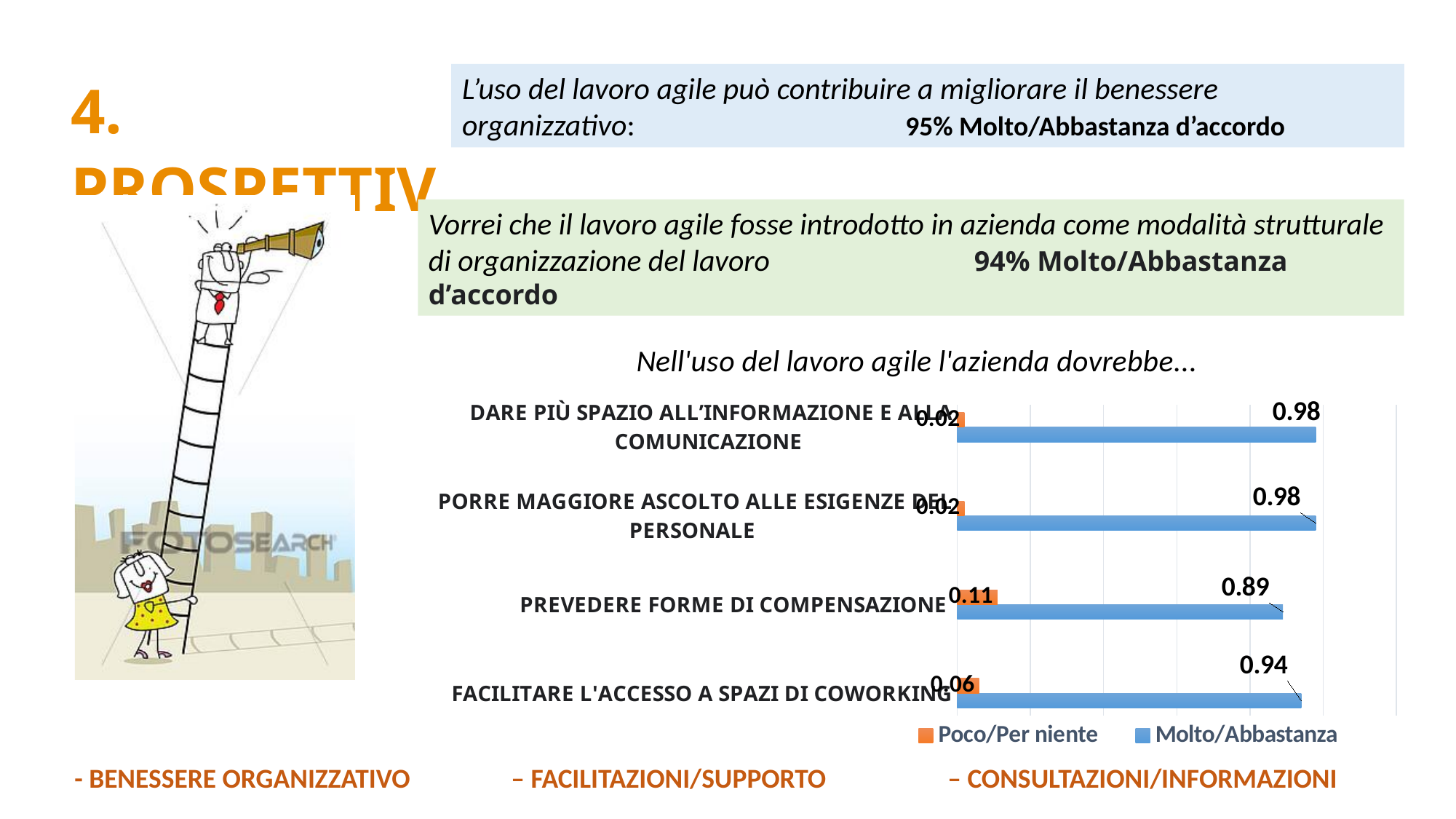
What is the Poco/Per niente value for 'Facilitare l'accesso a spazi di coworking'? 0.06 What is the difference between the Molto/Abbastanza values for 'Facilitare l'accesso a spazi di coworking' and 'Prevedere forme di compensazione'? 0.05 Which category has the highest Poco/Per niente value? Prevedere forme di compensazione What type of chart is shown on the slide? Bar chart What is the Molto/Abbastanza value for 'Prevedere forme di compensazione'? 0.89 What is the Molto/Abbastanza value for 'Porre maggiore ascolto alle esigenze del personale'? 0.98 What is the Poco/Per niente value for 'Prevedere forme di compensazione'? 0.11 How many series does the chart legend list? 2 What is the title of the chart? Nell'uso del lavoro agile l'azienda dovrebbe... Which category has the lowest Molto/Abbastanza value? Prevedere forme di compensazione Which is larger: the Molto/Abbastanza value for 'Facilitare l'accesso a spazi di coworking' or for 'Prevedere forme di compensazione'? Facilitare l'accesso a spazi di coworking How many categories are shown in the chart? 4